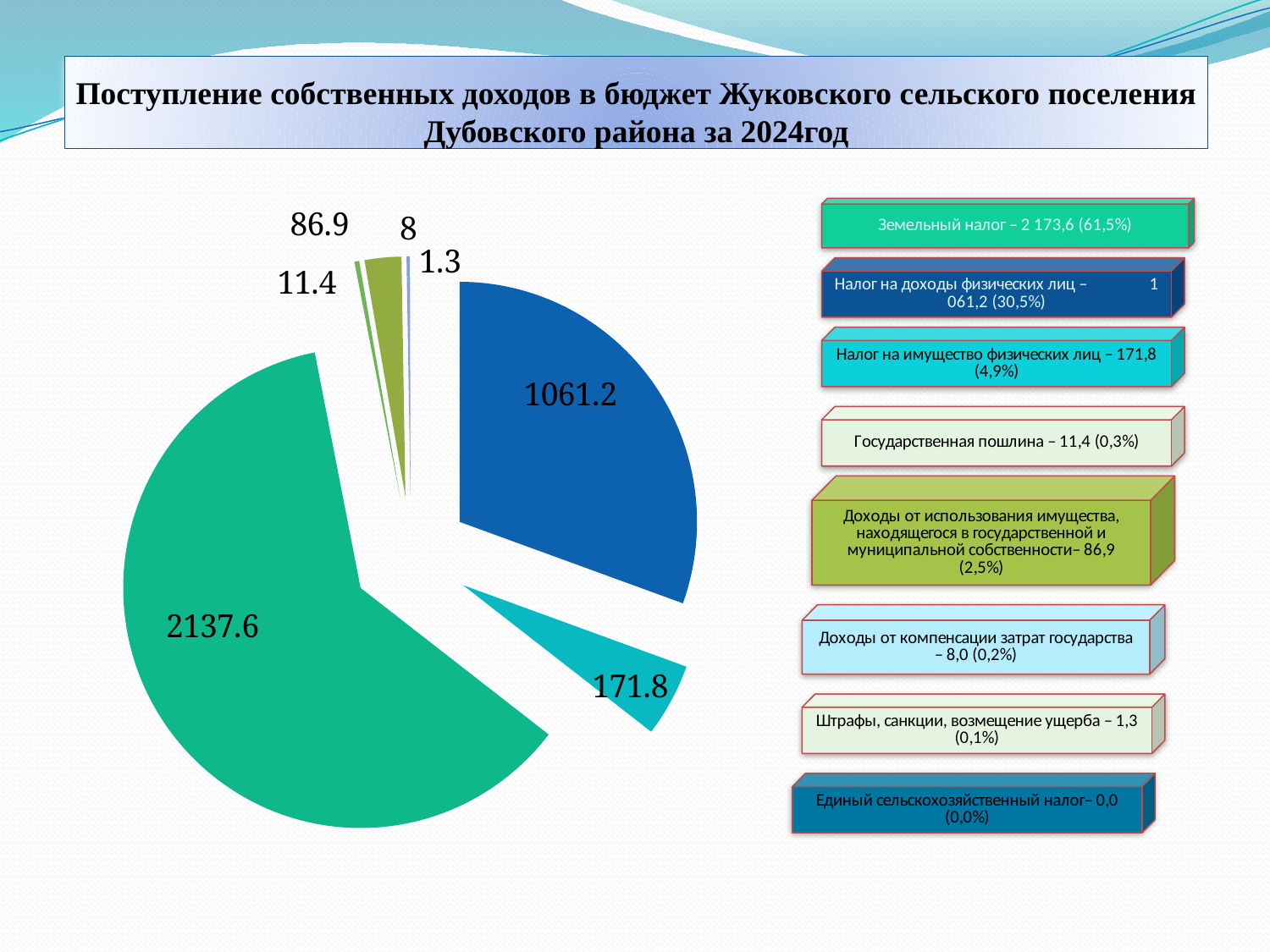
What value is printed on the dark blue slice of the pie chart (Налог на доходы физических лиц)? 1061.2 What value is printed on the olive-green slice of the pie chart (Доходы от использования имущества)? 86.9 What is the difference between the slice labelled 1061.2 and the slice labelled 171.8? 889.4 According to the legend, what share of the total does Земельный налог make up? 61,5% What kind of chart is shown on the slide? pie chart What value is printed on the largest slice of the pie chart? 2137.6 How many entries are listed in the legend on the right of the slide? 8 According to the legend, what share of the total does Налог на доходы физических лиц make up? 30,5% Which slice is larger: the one labelled 171.8 or the one labelled 86.9? 171.8 What value is printed on the smallest labelled slice of the pie chart? 1.3 How many labelled slices does the pie chart have? 7 What value is printed on the cyan slice of the pie chart (Налог на имущество физических лиц)? 171.8